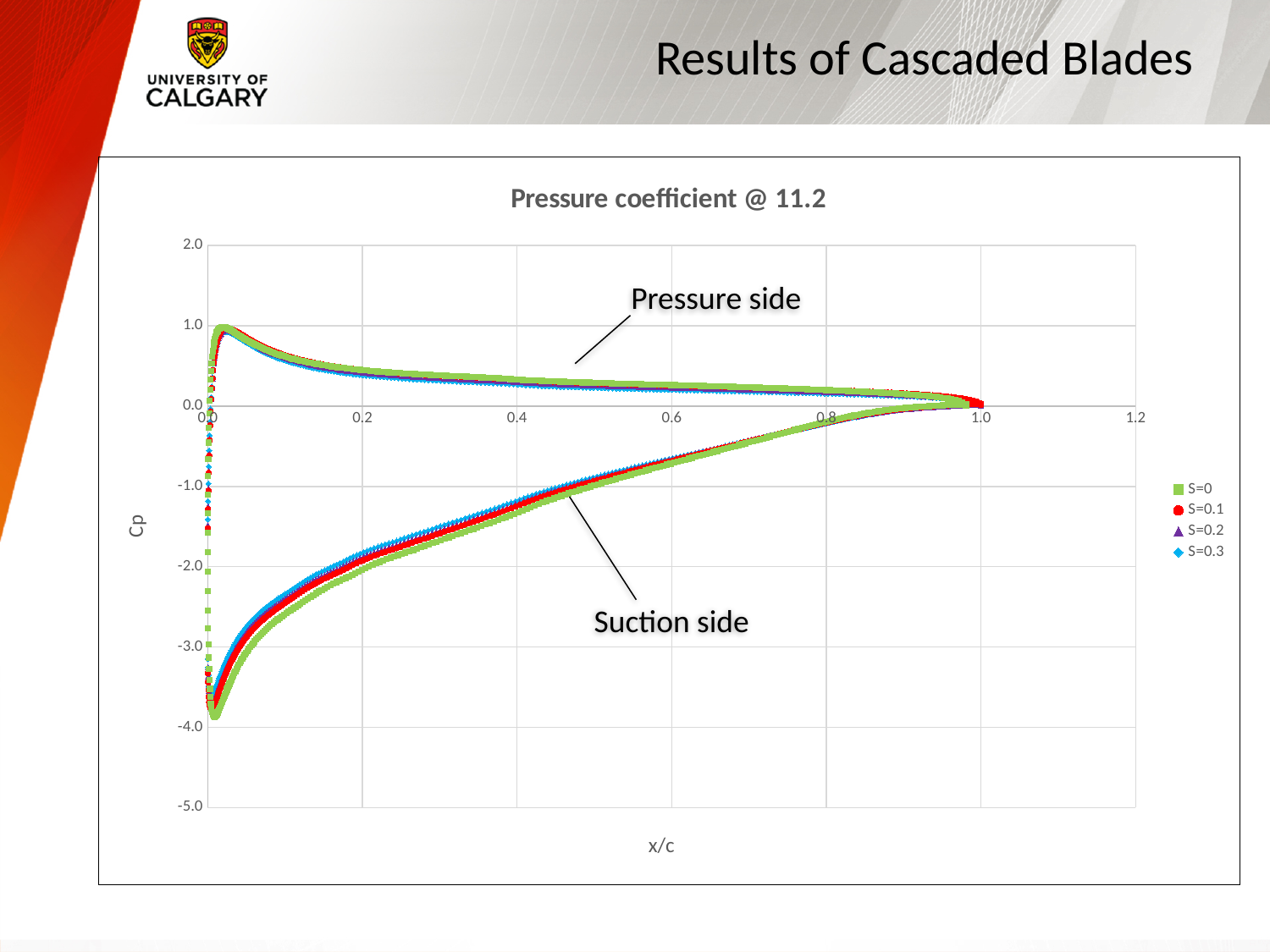
Which series is plotted with green square markers? S=0 How many series does the legend list? 4 Is the Cp value on the pressure side at x/c = 0.2 greater or less than 1.0? less Along the pressure side, does Cp rise or fall as x/c increases from 0.2 to 1.0? fall Is the lowest Cp value reached on the suction side greater or less than -3.0? less Is the Cp value on the suction side at x/c = 0.4 greater or less than -1.0? less Which side of the blade has the lower Cp values at x/c = 0.4, the pressure side or the suction side? Suction side Along the suction side, does Cp rise or fall as x/c increases from 0.2 to 1.0? rise What is the title of the chart? Pressure coefficient @ 11.2 What kind of chart is shown on the slide? Scatter chart